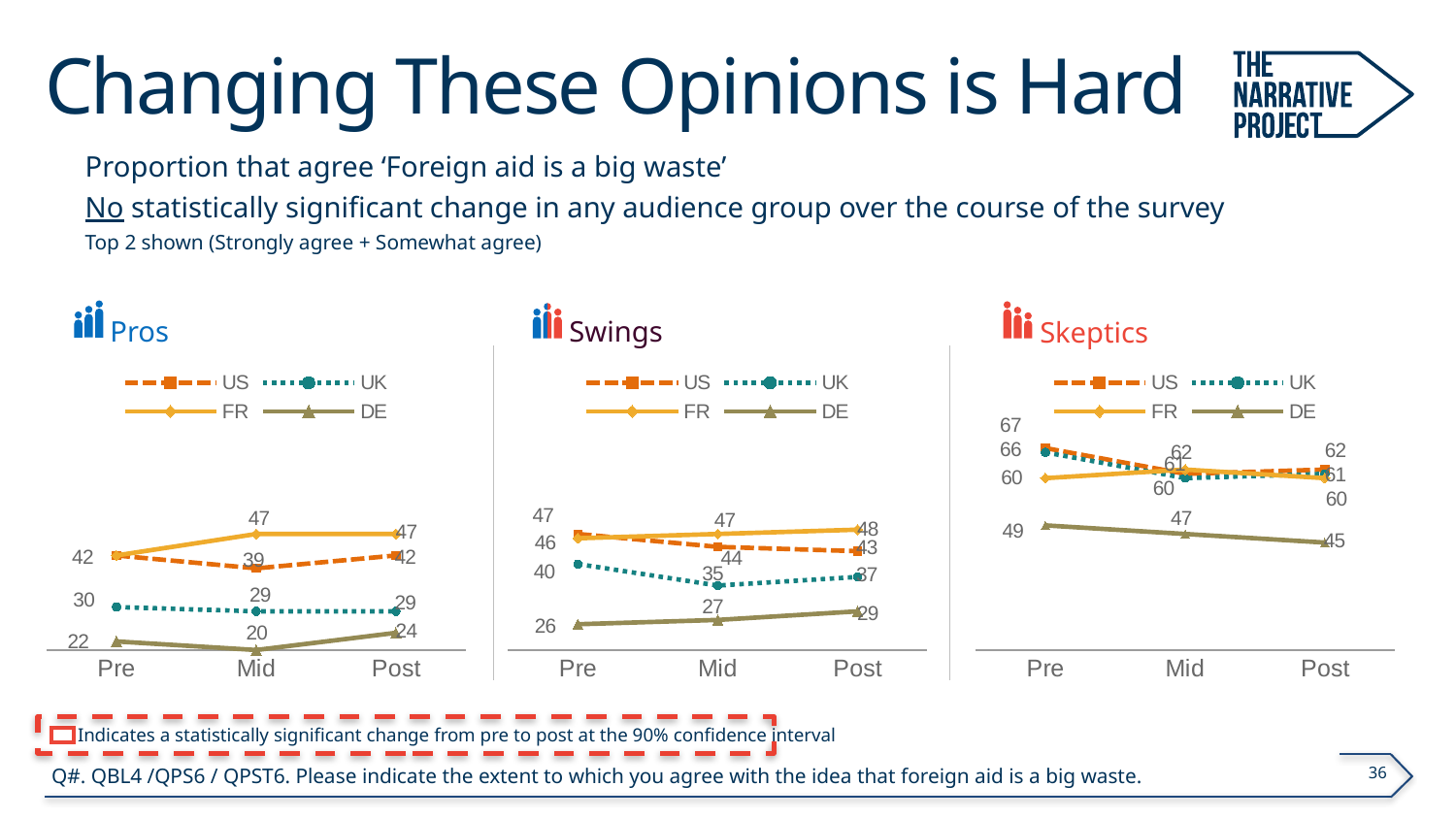
In the Swings chart, what is the value for DE at Pre? 26 In the Pros chart, what is the value for DE at Mid? 20 In the Swings chart, what is the value for UK at Mid? 35 In the Skeptics chart, does the DE series rise or fall from Pre to Post? fall In the Pros chart, which series has the highest value at Mid? FR How many points along the x axis does the Pros chart have? 3 In the Skeptics chart, what is the value for DE at Pre? 49 What kind of chart is used for the Pros, Swings and Skeptics panels? line chart How many series does the legend list in the Swings chart? 4 In the Pros chart, what is the difference between FR and DE at Post? 23 In the Swings chart, which is larger at Post, FR or US? FR In the Pros chart, what is the value for FR at Mid? 47